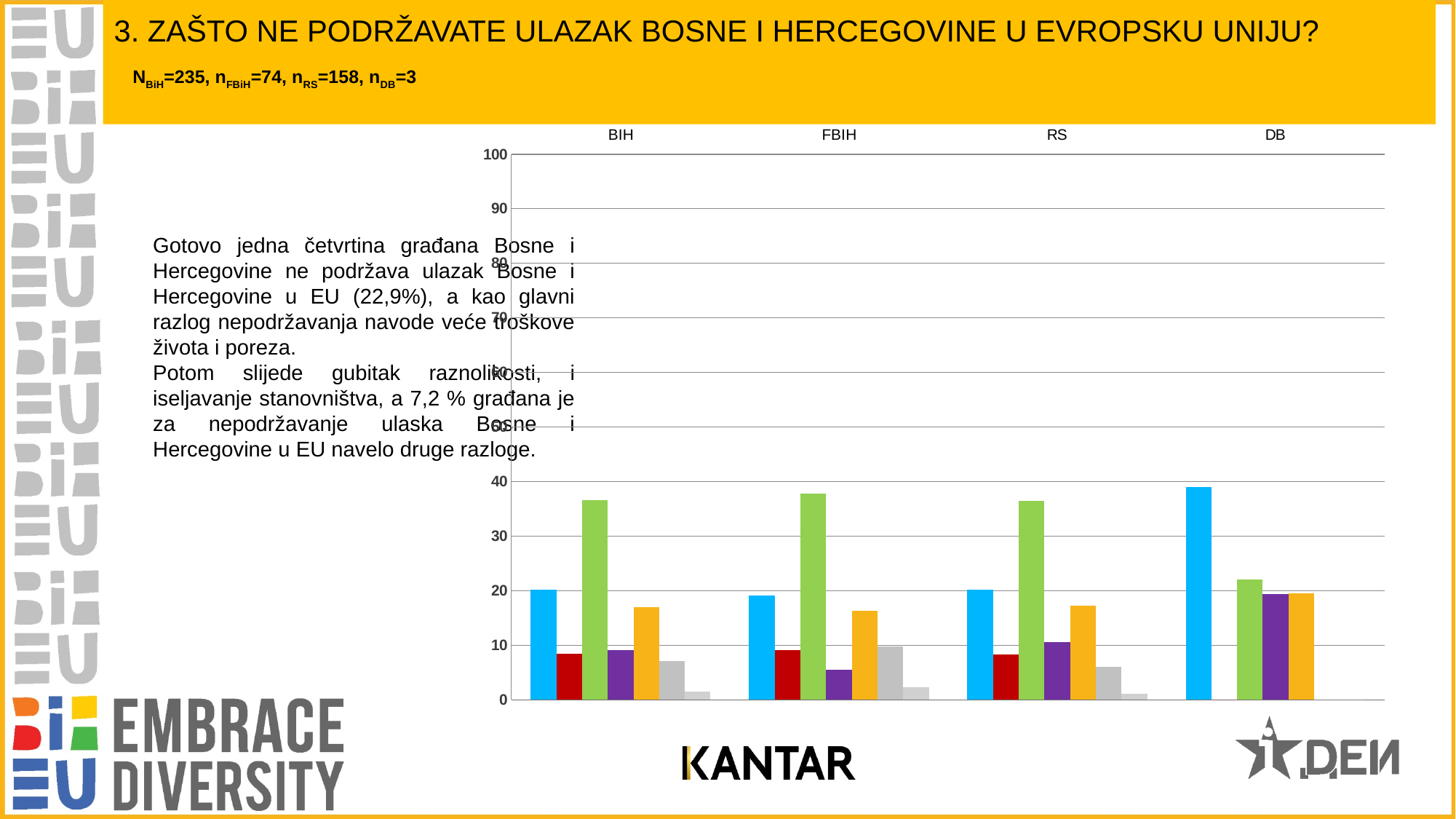
Is the value of the purple bar for DB greater or less than 10? greater Is the value of the green bar for BIH greater or less than 30? greater How many categories are shown along the x axis of the chart? 4 Which category has the tallest light blue bar? DB Is the value of the orange bar for BIH greater or less than 20? less What kind of chart is shown on the slide? bar chart For DB, which is larger: the light blue bar or the green bar? the light blue bar What is the highest value shown on the y axis of the chart? 100 Which category has the shortest green bar? DB For BIH, which is larger: the green bar or the orange bar? the green bar